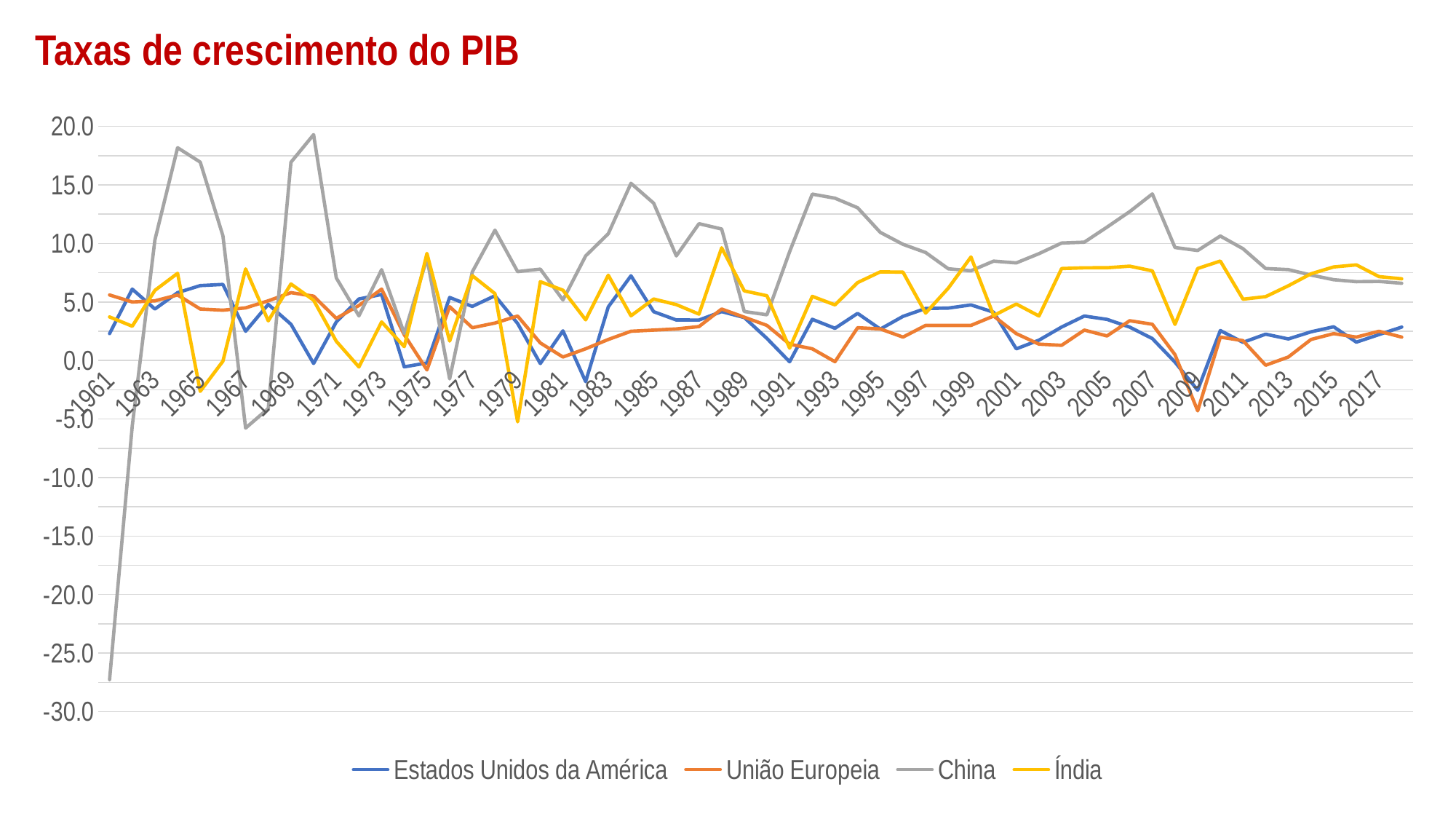
Does the value for China rise or fall from 1961 to 1964? rise Which series reaches the lowest value anywhere on the chart? China How many series does the legend list? 4 What kind of chart is shown on the slide? line chart Which series reaches the highest value anywhere on the chart? China Is the value for Estados Unidos da América in 2009 greater or less than 0.0? less Is the value for Índia in 1979 greater or less than 0.0? less In 2007, which is higher: China or Estados Unidos da América? China Is the value for China in 1961 greater or less than -20.0? less What is the title of the chart? Taxas de crescimento do PIB Which series is drawn in grey? China